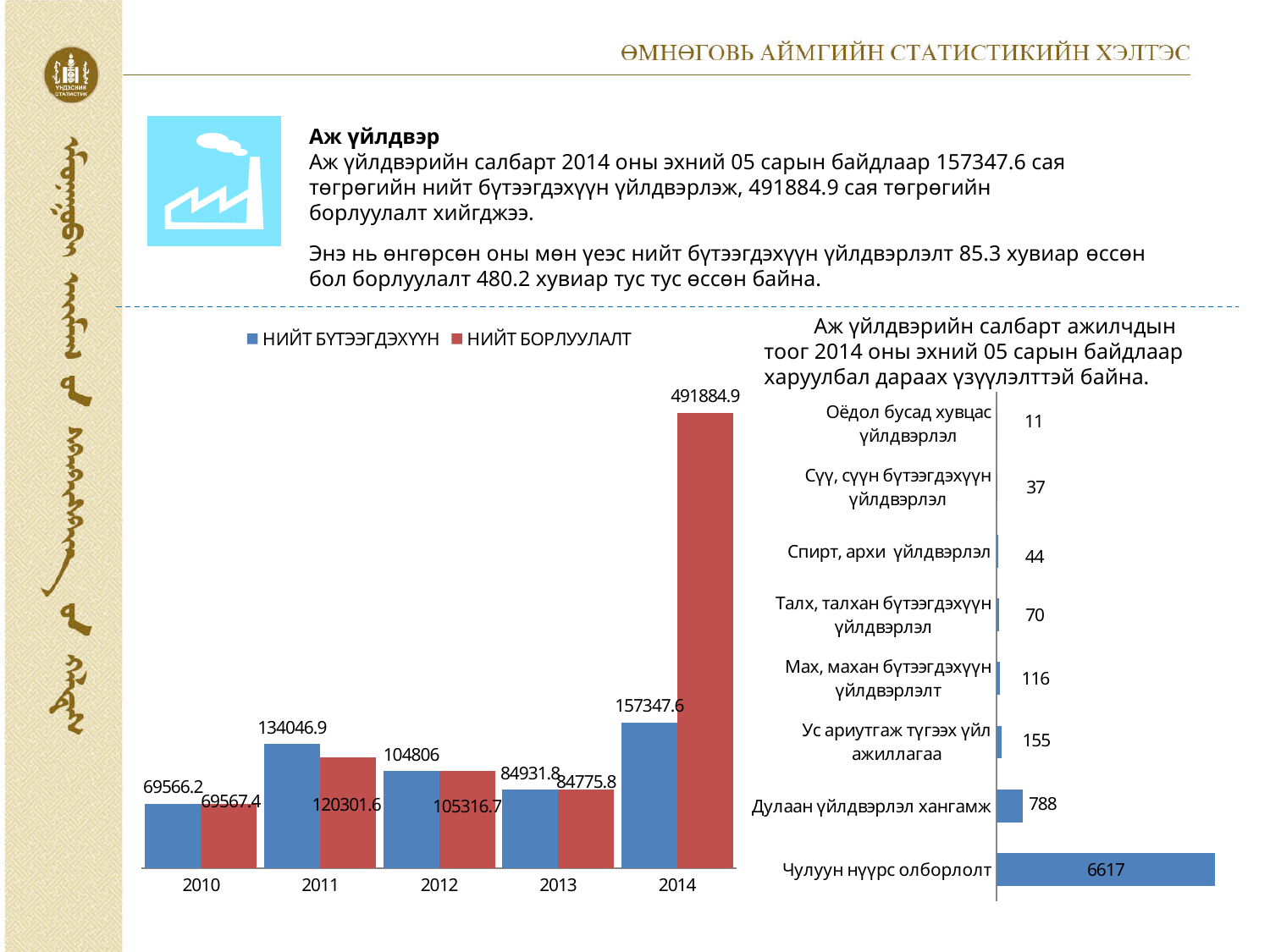
In the left chart, what is the value of НИЙТ БОРЛУУЛАЛТ for 2014? 491884.9 In the left chart, which year has the lowest value for НИЙТ БОРЛУУЛАЛТ? 2010 In the right chart (Аж үйлдвэрийн салбарт ажилчдын тоо), what is the difference between Дулаан үйлдвэрлэл хангамж and Ус ариутгаж түгээх үйл ажиллагаа? 633 In the left chart, which is larger in 2011: НИЙТ БҮТЭЭГДЭХҮҮН or НИЙТ БОРЛУУЛАЛТ? НИЙТ БҮТЭЭГДЭХҮҮН In the right chart (Аж үйлдвэрийн салбарт ажилчдын тоо), which category has the lowest value? Оёдол бусад хувцас үйлдвэрлэл In the left chart, what is the value of НИЙТ БҮТЭЭГДЭХҮҮН for 2011? 134046.9 In the left chart, which year has the highest value for НИЙТ БҮТЭЭГДЭХҮҮН? 2014 How many series does the legend of the left chart list? 2 How many years are shown on the x axis of the left chart? 5 What kind of chart is the left chart? Bar chart In the left chart, what is the difference between НИЙТ БОРЛУУЛАЛТ and НИЙТ БҮТЭЭГДЭХҮҮН in 2014? 334537.3 In the right chart (Аж үйлдвэрийн салбарт ажилчдын тоо), what is the value for Чулуун нүүрс олборлолт? 6617